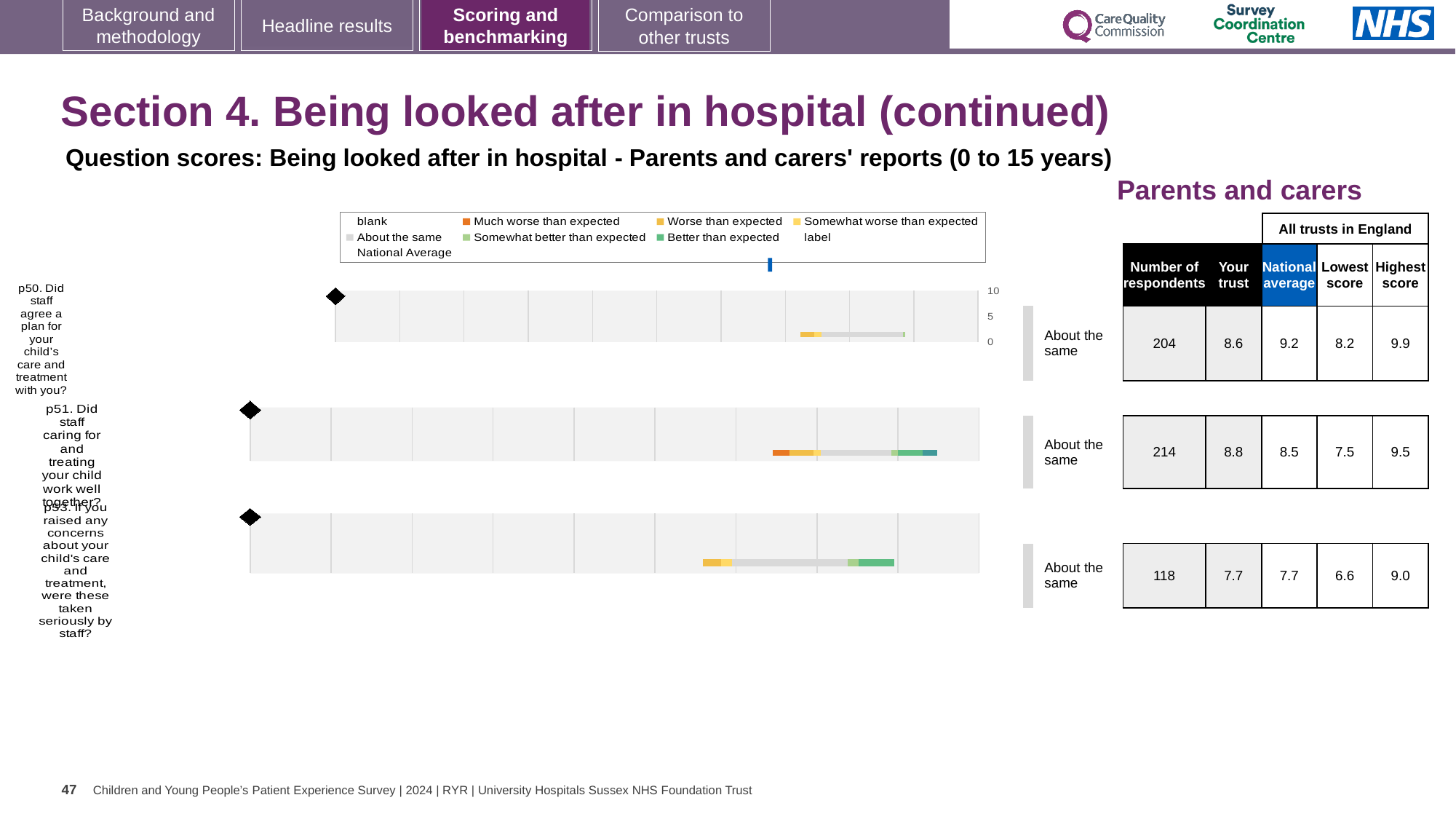
How many respondents answered p53 (If you raised any concerns about your child's care and treatment, were these taken seriously by staff?)? 118 What is the difference between the highest score and the lowest score for p50? 1.7 How many survey questions are plotted on the slide? 3 What is the 'Your trust' score for p50 (Did staff agree a plan for your child's care and treatment with you?)? 8.6 What is the national average score for p51 (Did staff caring for and treating your child work well together?)? 8.5 Which question has the lowest number of respondents? p53 What is the highest score among all trusts in England for p53? 9.0 Which question has the highest 'Your trust' score? p51 What kind of chart is used to show the question scores on this slide? Bar chart What is the maximum value shown on the score axis of the charts? 10 What benchmark category is shown for p50? About the same For p51, which is larger: the 'Your trust' score or the national average? Your trust